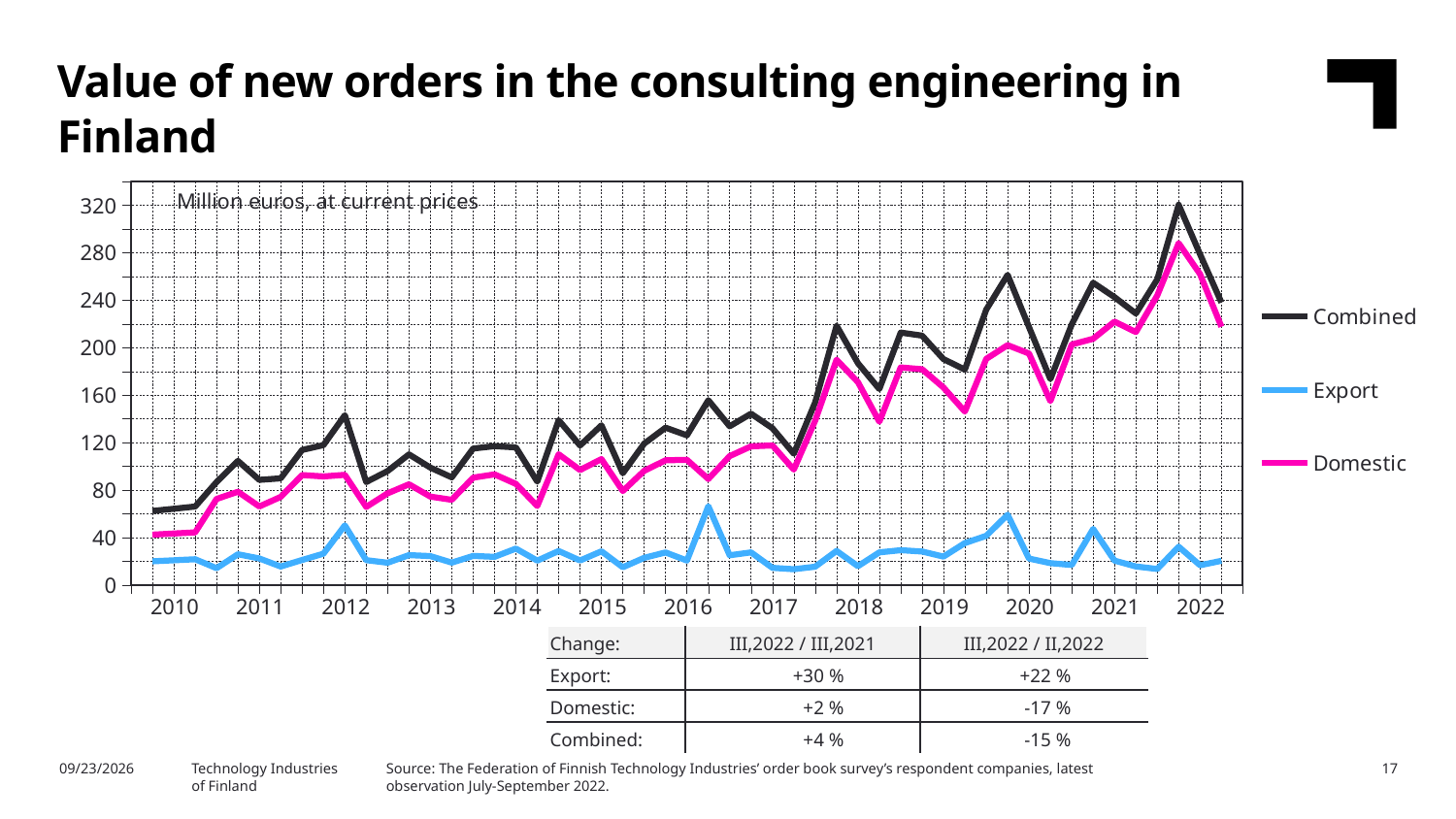
Is the highest value reached by the Combined series greater or less than 280? greater What are the three series named in the chart's legend? Combined, Export, Domestic Which series has the lowest values across the whole period shown? Export Is the value of the Domestic series at the start of 2010 greater or less than 80? less What unit is stated at the top of the chart for the plotted values? Million euros, at current prices Is the peak of the Export series in 2016 greater or less than 40? greater In 2022, which series has the higher values, Export or Domestic? Domestic How many years are labelled on the x axis of the chart? 13 How many series does the chart's legend list? 3 What kind of chart is shown on the slide? line chart Does the Combined series overall rise or fall from 2010 to 2022? rise